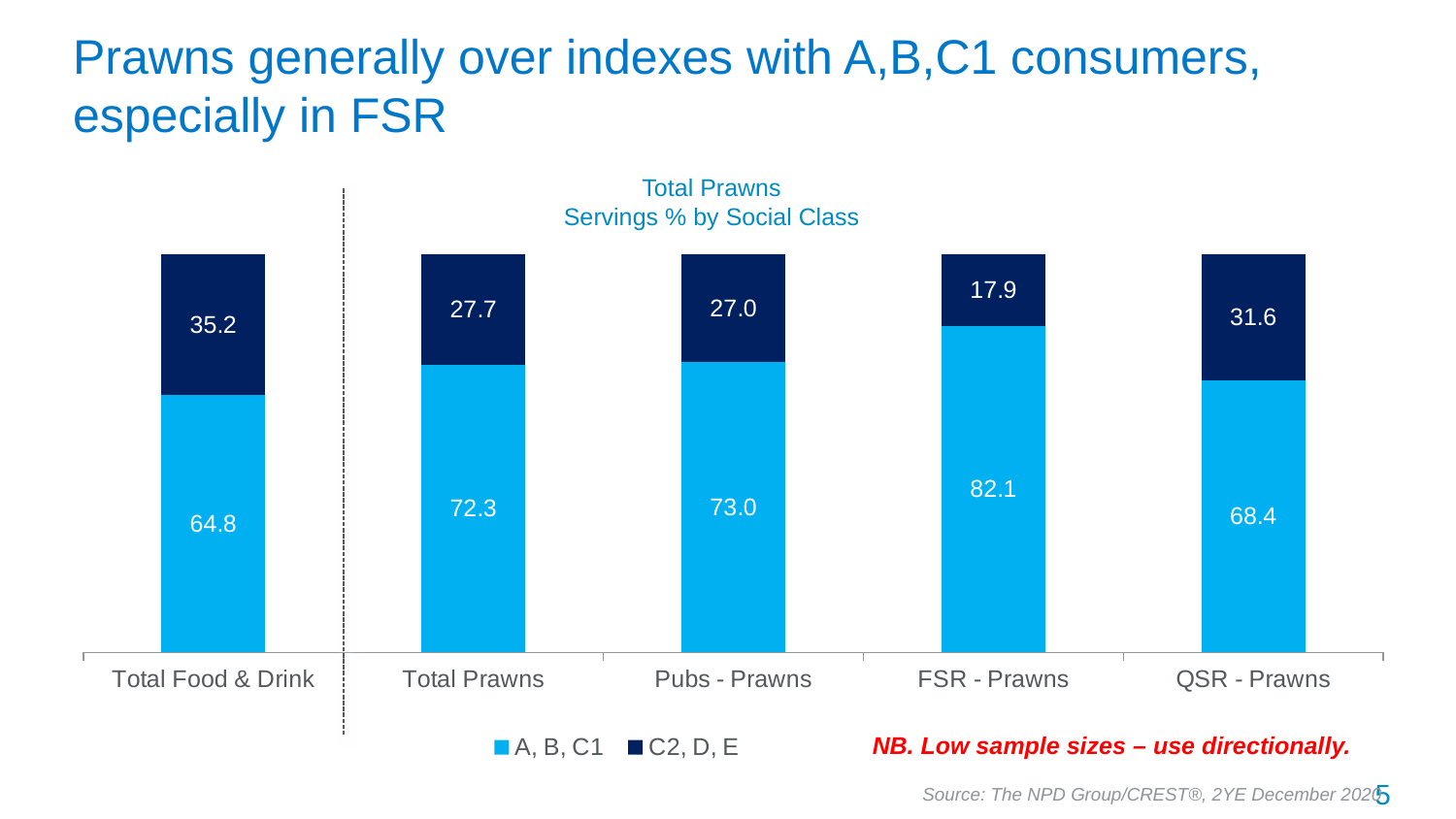
How many categories are shown on the x axis? 5 Which category has the highest A, B, C1 value? FSR - Prawns What is the difference between the A, B, C1 values for FSR - Prawns and Total Food & Drink? 17.3 What is the total of the stacked bar for Pubs - Prawns? 100.0 Which is larger, the C2, D, E value for QSR - Prawns or for Pubs - Prawns? QSR - Prawns What kind of chart is shown? Stacked bar chart How many series does the legend list? 2 What is the C2, D, E value for Total Food & Drink? 35.2 What is the title of the chart? Total Prawns Servings % by Social Class Which category has the lowest C2, D, E value? FSR - Prawns What is the A, B, C1 value for FSR - Prawns? 82.1 What is the A, B, C1 value for Total Prawns? 72.3